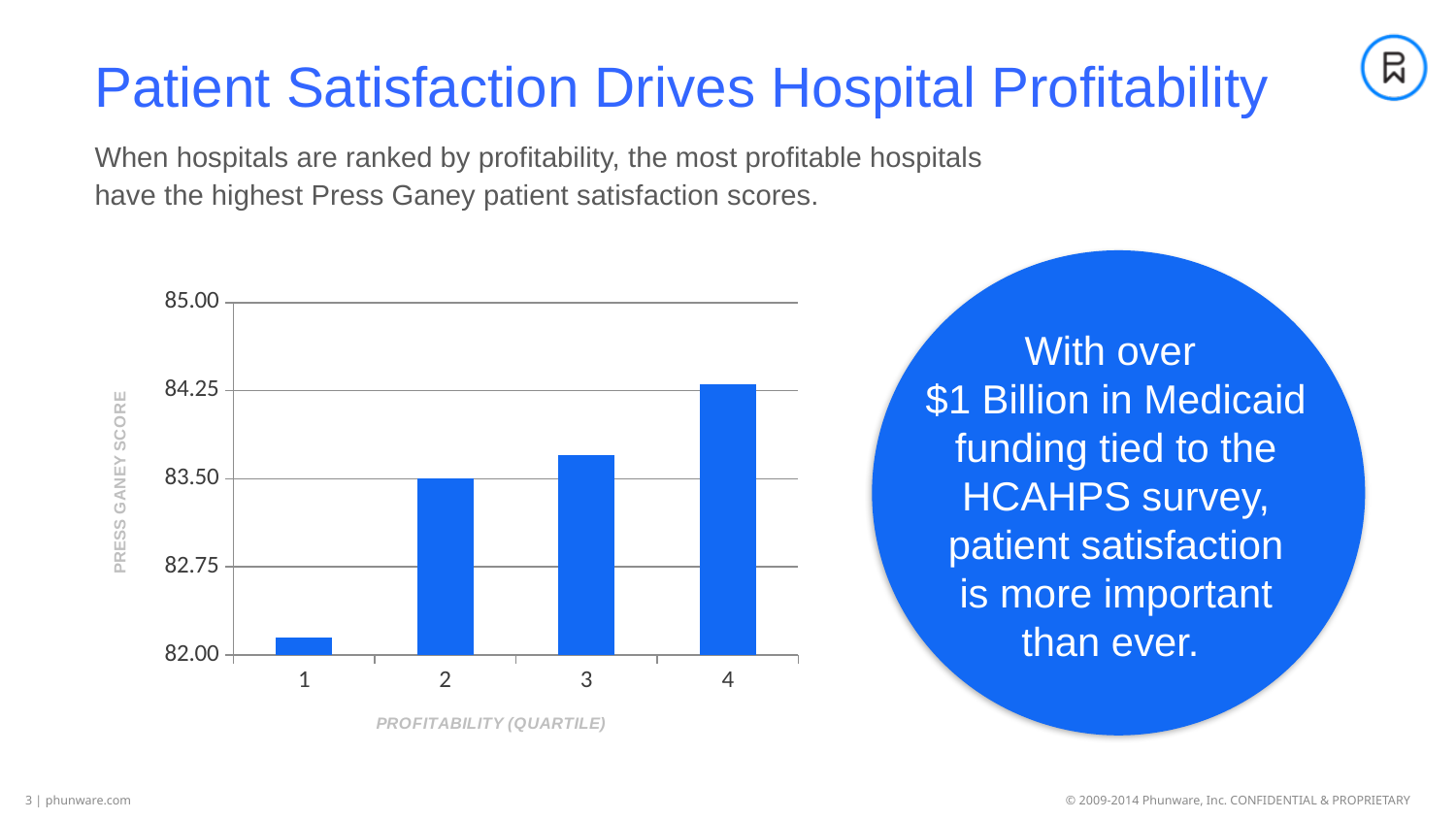
What is the label of the x axis of the chart? PROFITABILITY (QUARTILE) Which has a lower Press Ganey score, quartile 1 or quartile 3? quartile 1 What is the label of the y axis of the chart? PRESS GANEY SCORE Which has a higher Press Ganey score, quartile 2 or quartile 4? quartile 4 Which profitability quartile has the highest Press Ganey score? 4 Do the Press Ganey scores rise or fall as the profitability quartile increases from 1 to 4? rise What kind of chart is shown on the slide? bar chart How many profitability quartiles are plotted on the x axis? 4 Which profitability quartile has the lowest Press Ganey score? 1 Is the Press Ganey score for quartile 1 greater or less than 82.75? less Is the Press Ganey score for quartile 3 greater or less than 84.25? less